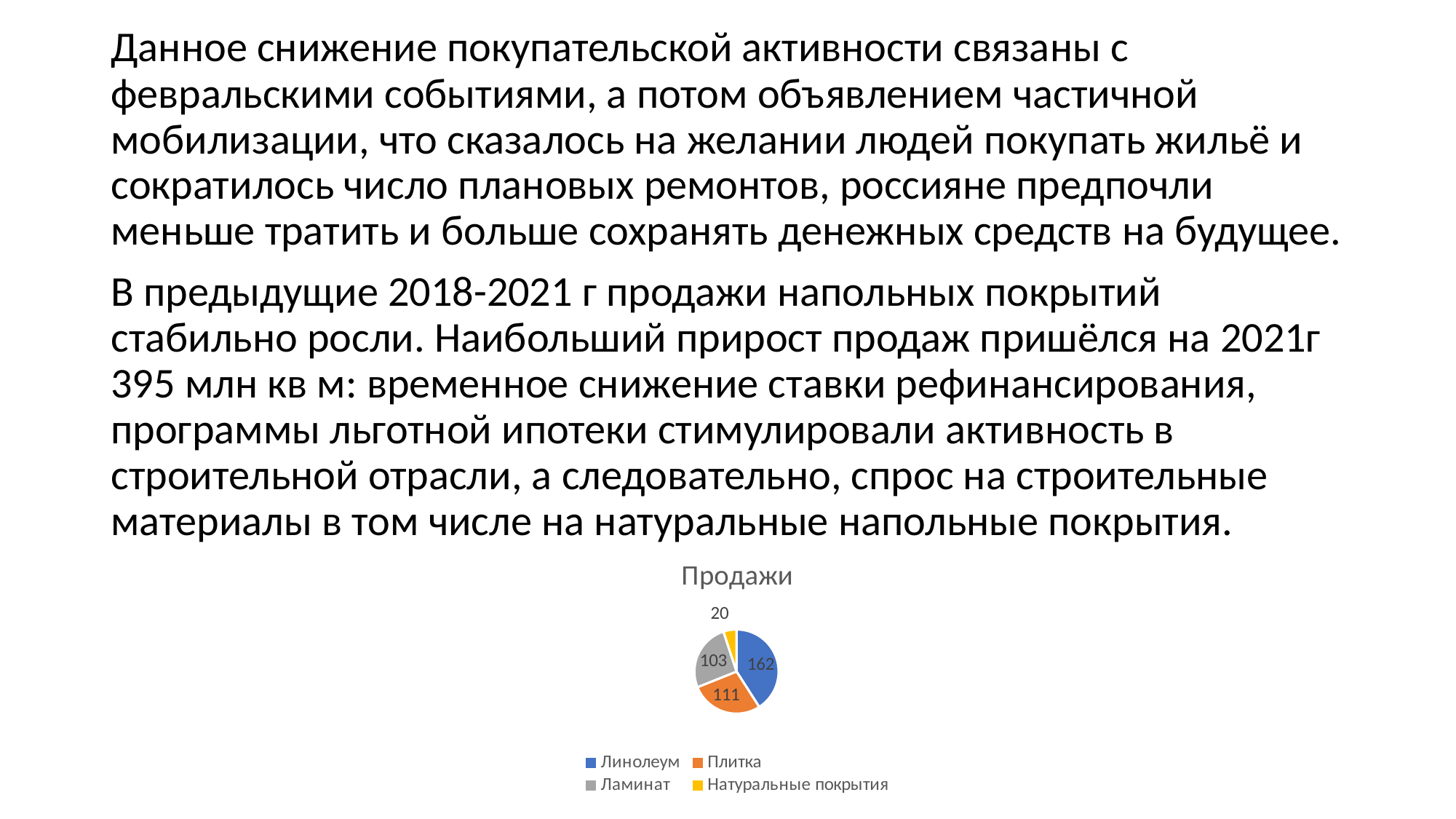
What is the total of all slices in the pie chart? 396 What is the value for Натуральные покрытия in the pie chart? 20 What is the value for Линолеум in the pie chart? 162 What is the value for Плитка in the pie chart? 111 What is the difference between the values for Линолеум and Плитка? 51 What is the value for Ламинат in the pie chart? 103 Which category has the smallest slice in the pie chart? Натуральные покрытия What type of chart is shown on the slide? pie chart Which category has the largest slice in the pie chart? Линолеум What is the title of the chart? Продажи Which is larger, the value for Плитка or the value for Ламинат? Плитка How many categories does the pie chart have? 4